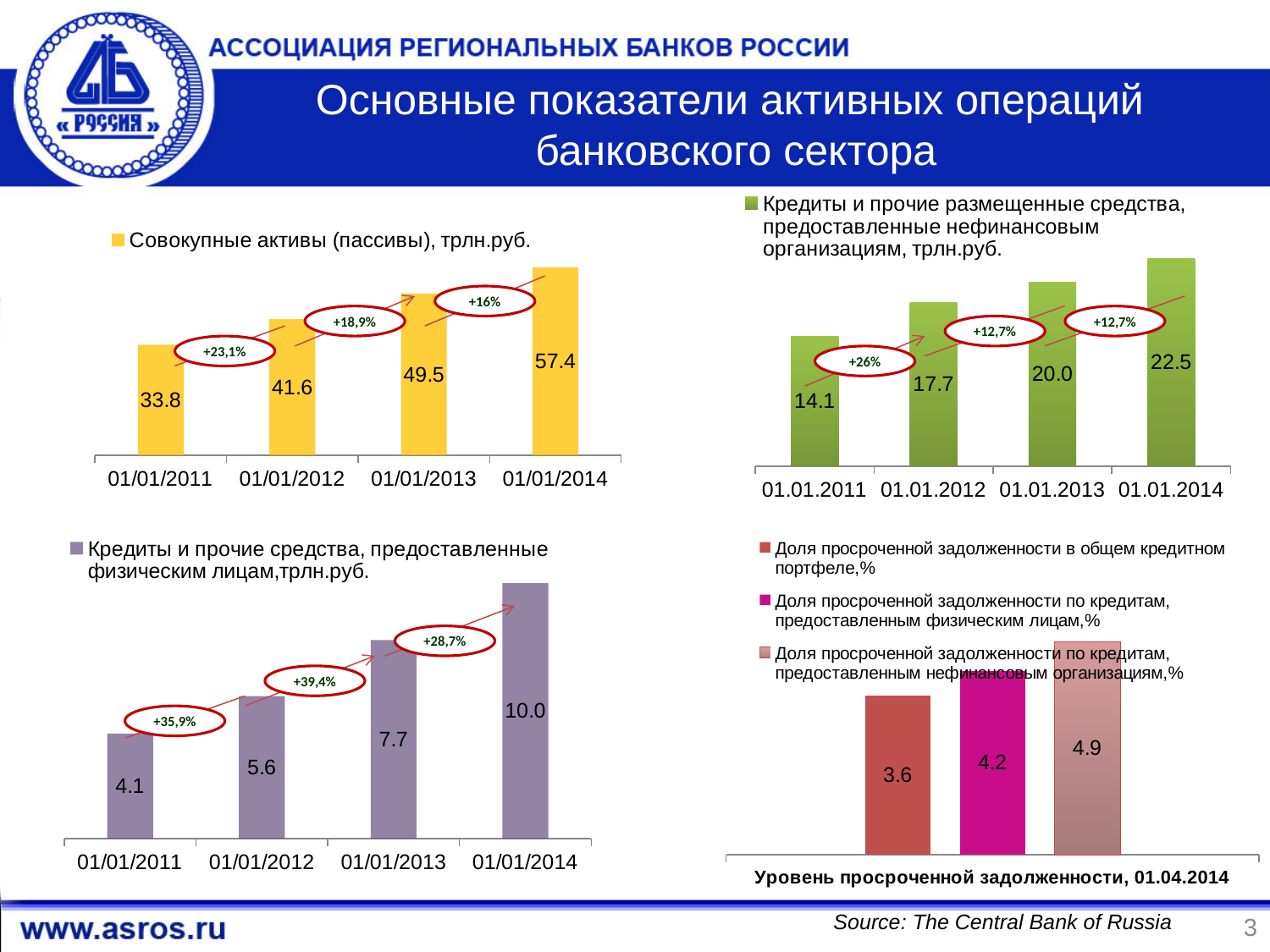
On the bottom-left chart (Кредиты и прочие средства, предоставленные физическим лицам, трлн.руб.), how many dates are plotted? 4 On the bottom-right chart (Уровень просроченной задолженности, 01.04.2014), what is the value for Доля просроченной задолженности по кредитам, предоставленным нефинансовым организациям,%? 4.9 On the bottom-right chart (Уровень просроченной задолженности, 01.04.2014), how many series does the legend list? 3 On the top-left chart (Совокупные активы (пассивы), трлн.руб.), do the values rise or fall from 01/01/2011 to 01/01/2014? rise On the top-right chart (Кредиты и прочие размещенные средства, предоставленные нефинансовым организациям, трлн.руб.), which date has the lowest value? 01.01.2011 On the top-right chart (Кредиты и прочие размещенные средства, предоставленные нефинансовым организациям, трлн.руб.), what is the value for 01.01.2012? 17.7 On the bottom-left chart (Кредиты и прочие средства, предоставленные физическим лицам, трлн.руб.), what is the value for 01/01/2013? 7.7 On the bottom-left chart (Кредиты и прочие средства, предоставленные физическим лицам, трлн.руб.), what is the difference between the values for 01/01/2012 and 01/01/2011? 1.5 What type of chart is the top-left chart (Совокупные активы (пассивы), трлн.руб.)? bar chart On the top-left chart (Совокупные активы (пассивы), трлн.руб.), what is the difference between the values for 01/01/2014 and 01/01/2011? 23.6 On the top-left chart (Совокупные активы (пассивы), трлн.руб.), what is the value for 01/01/2014? 57.4 On the top-right chart (Кредиты и прочие размещенные средства, предоставленные нефинансовым организациям, трлн.руб.), what growth percentage is shown between 01.01.2011 and 01.01.2012? +26%